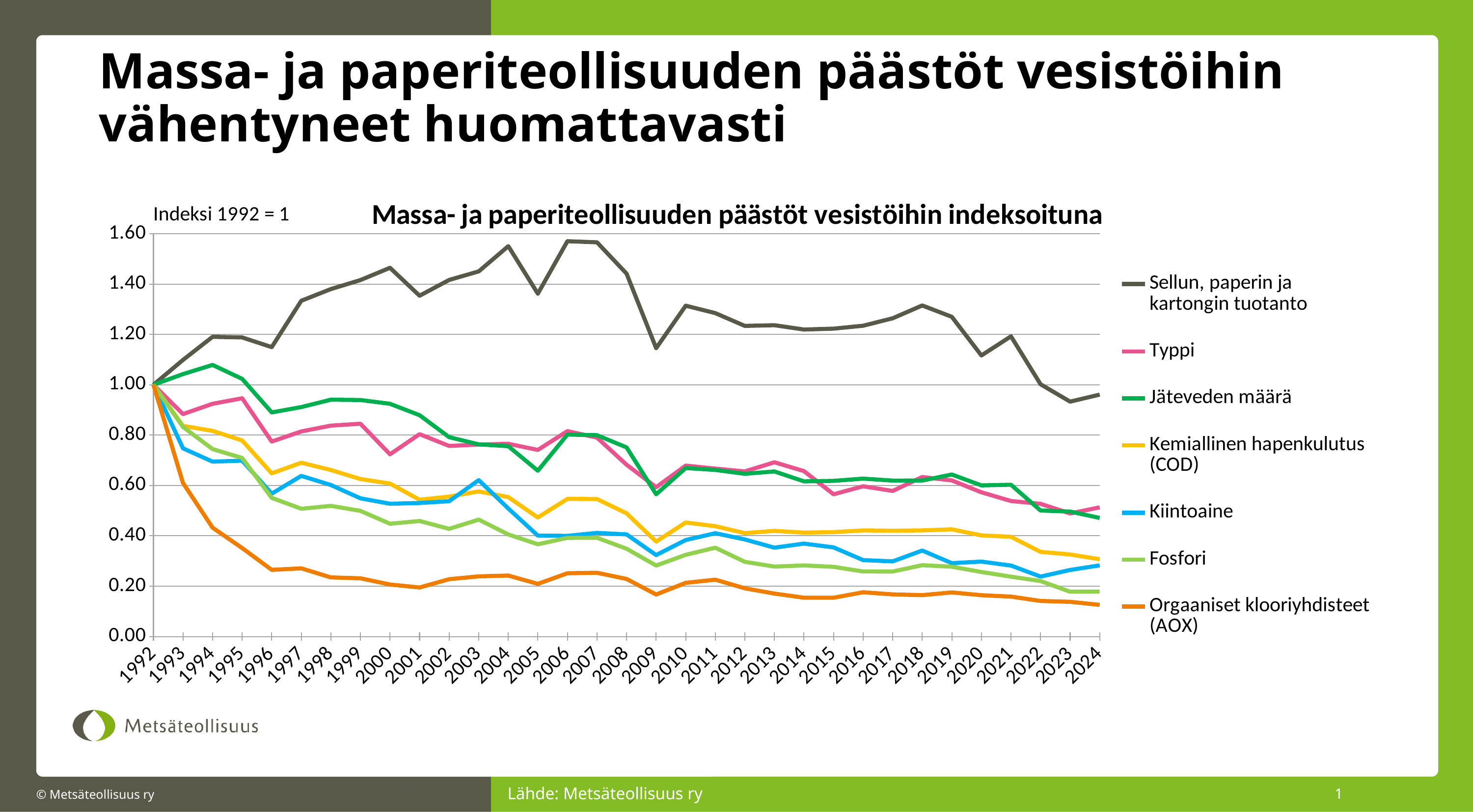
Is the value for Typpi in 2024 greater or less than 0.40? greater Which series has the highest value in 2024? Sellun, paperin ja kartongin tuotanto Is the value for Orgaaniset klooriyhdisteet (AOX) in 2024 greater or less than 0.20? less Which series has the lowest value in 2024? Orgaaniset klooriyhdisteet (AOX) Is the value for Sellun, paperin ja kartongin tuotanto in 2006 greater or less than 1.40? greater What kind of chart is shown on the slide? line chart How many series does the legend list? 7 Does the Orgaaniset klooriyhdisteet (AOX) series generally rise or fall from 1992 to 2024? fall How many years are plotted along the x axis? 33 Which is larger for Sellun, paperin ja kartongin tuotanto: the value in 2006 or the value in 2024? 2006 What is the index value of every series in 1992? 1.00